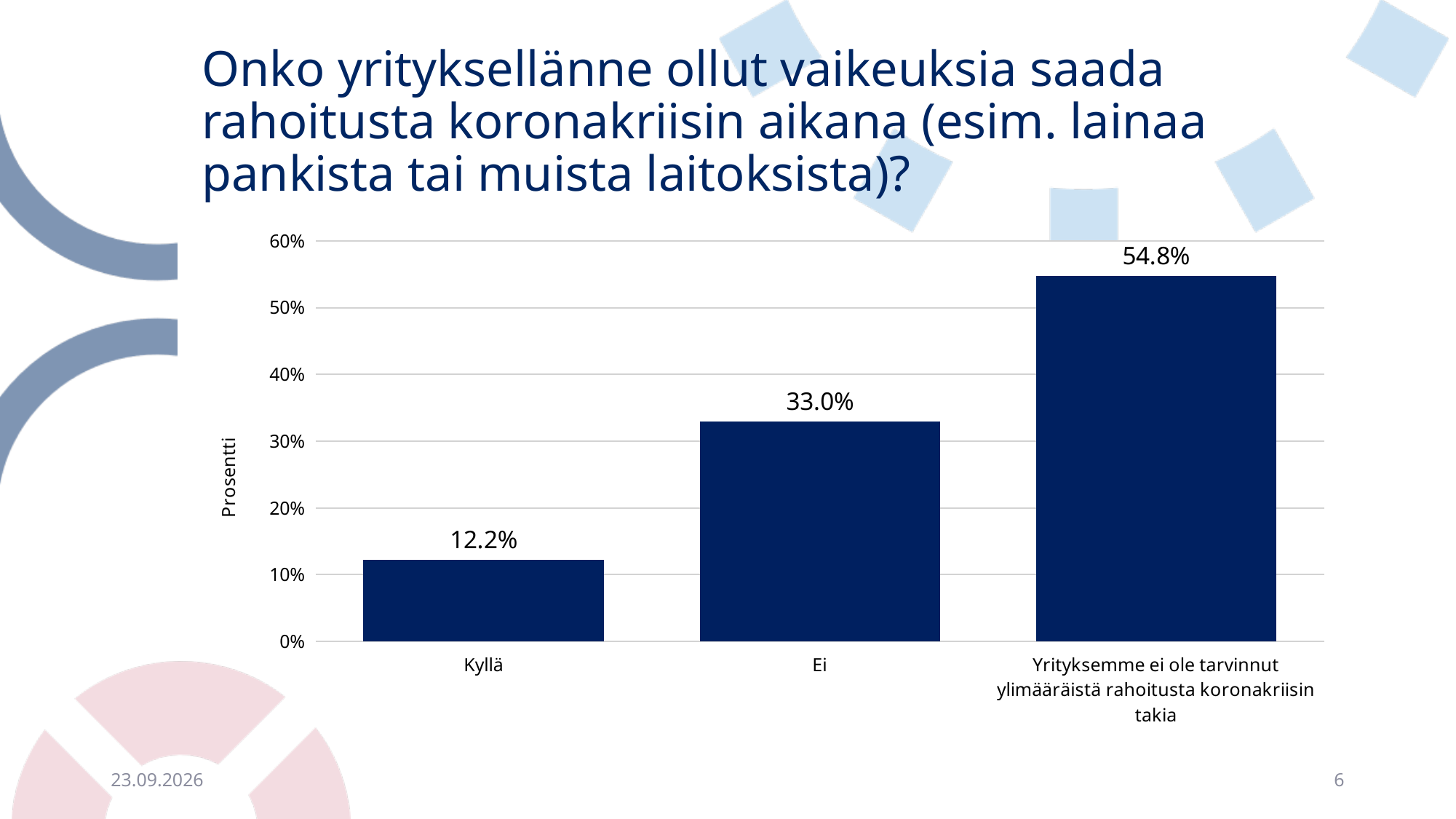
What kind of chart is shown on the slide? Bar chart What is the difference between the values for Ei and Kyllä? 20.8% What is the difference between the highest and lowest values? 42.6% What is the value for 'Yrityksemme ei ole tarvinnut ylimääräistä rahoitusta koronakriisin takia'? 54.8% Which category has the lowest value? Kyllä Which category has the highest value? Yrityksemme ei ole tarvinnut ylimääräistä rahoitusta koronakriisin takia How many categories are shown in the chart? 3 What is the value for Kyllä? 12.2% Is the value for Ei greater or less than 30%? greater What is the value for Ei? 33.0% Which is larger, the value for Ei or the value for Kyllä? Ei What is the label of the vertical axis? Prosentti